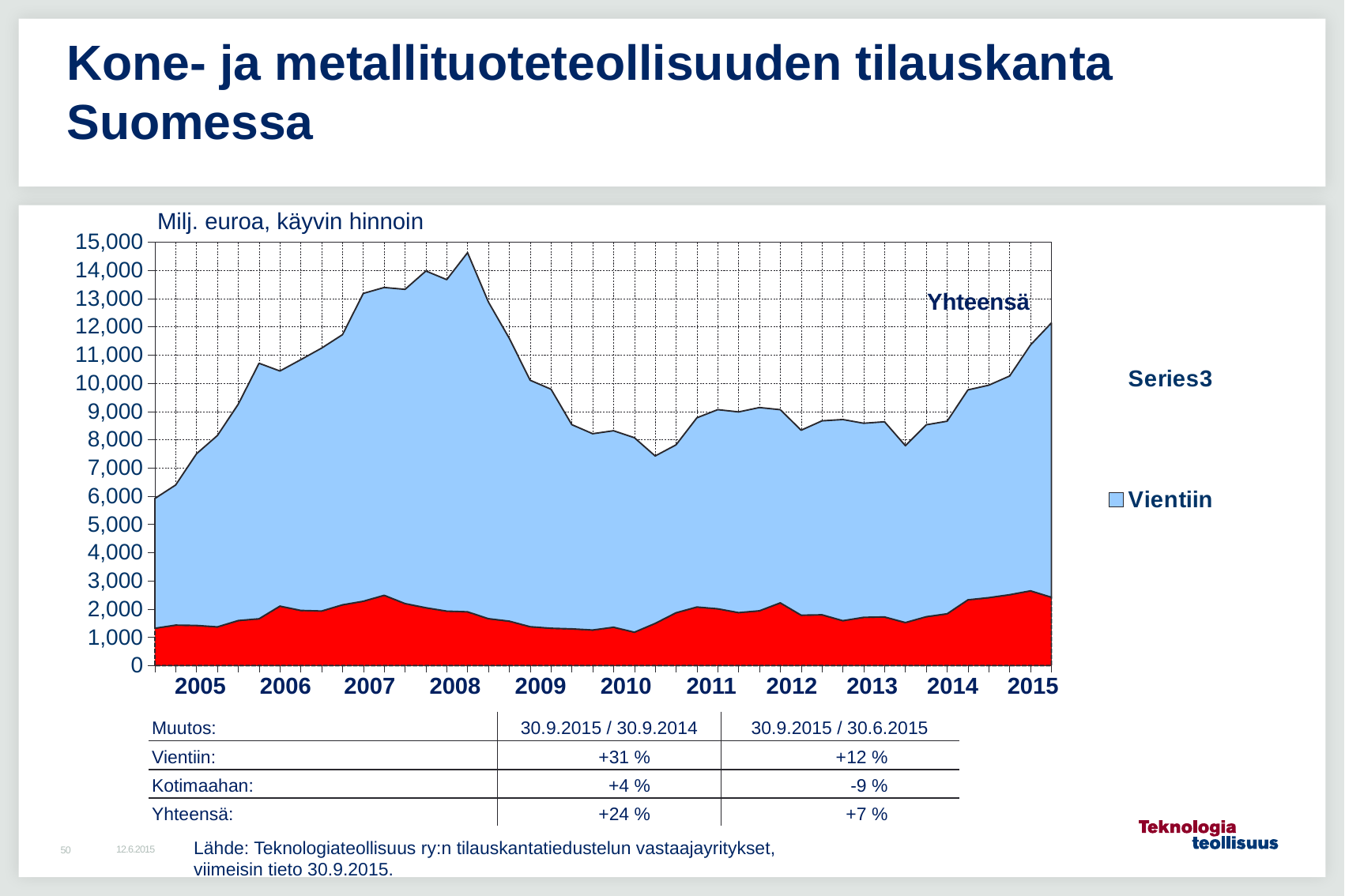
What unit label is shown above the chart's y axis? Milj. euroa, käyvin hinnoin Is the peak value of the total (Yhteensä) in 2008 greater or less than 14,000? greater Which is larger, the total (Yhteensä) in 2008 or in 2012? 2008 Is the lowest total (Yhteensä) value in 2010 greater or less than 8,000? less Does the total (Yhteensä) rise or fall between its 2008 peak and 2010? fall In which year does the total (Yhteensä) order backlog reach its highest point? 2008 How many years are labelled on the x axis of the chart? 11 Is the total (Yhteensä) value at the start of 2005 greater or less than 7,000? less What kind of chart is shown on the slide? area chart How many series does the chart legend list? 2